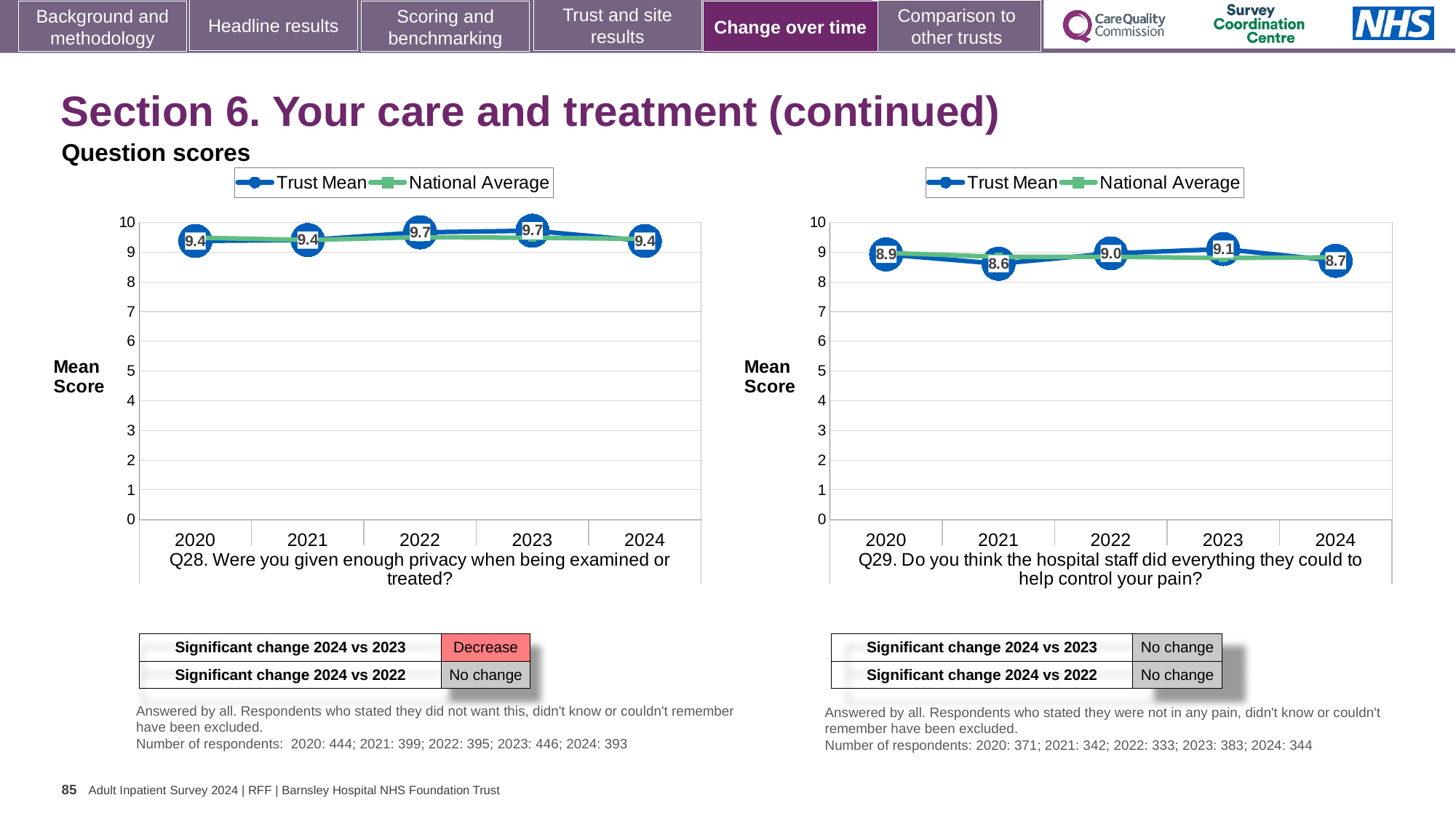
In the Q28 chart (left), what is the Trust Mean score for 2022? 9.7 How many years are plotted on the x axis of the Q28 chart (left)? 5 In the Q29 chart (right), which year has the larger Trust Mean score, 2020 or 2021? 2020 In the Q29 chart (right), what is the Trust Mean score for 2021? 8.6 In the Q28 chart (left), is the National Average value for 2024 greater or less than 8? greater In the Q29 chart (right), which year has the highest Trust Mean score? 2023 In the Q29 chart (right), what does the table show for Significant change 2024 vs 2023? No change In the Q29 chart (right), which year has the lowest Trust Mean score? 2021 In the Q29 chart (right), what is the difference between the Trust Mean scores for 2023 and 2021? 0.5 What kind of chart is used for Q28 (left)? Line chart How many series does the legend of the Q29 chart (right) list? 2 In the Q28 chart (left), what is the difference between the Trust Mean scores for 2023 and 2024? 0.3